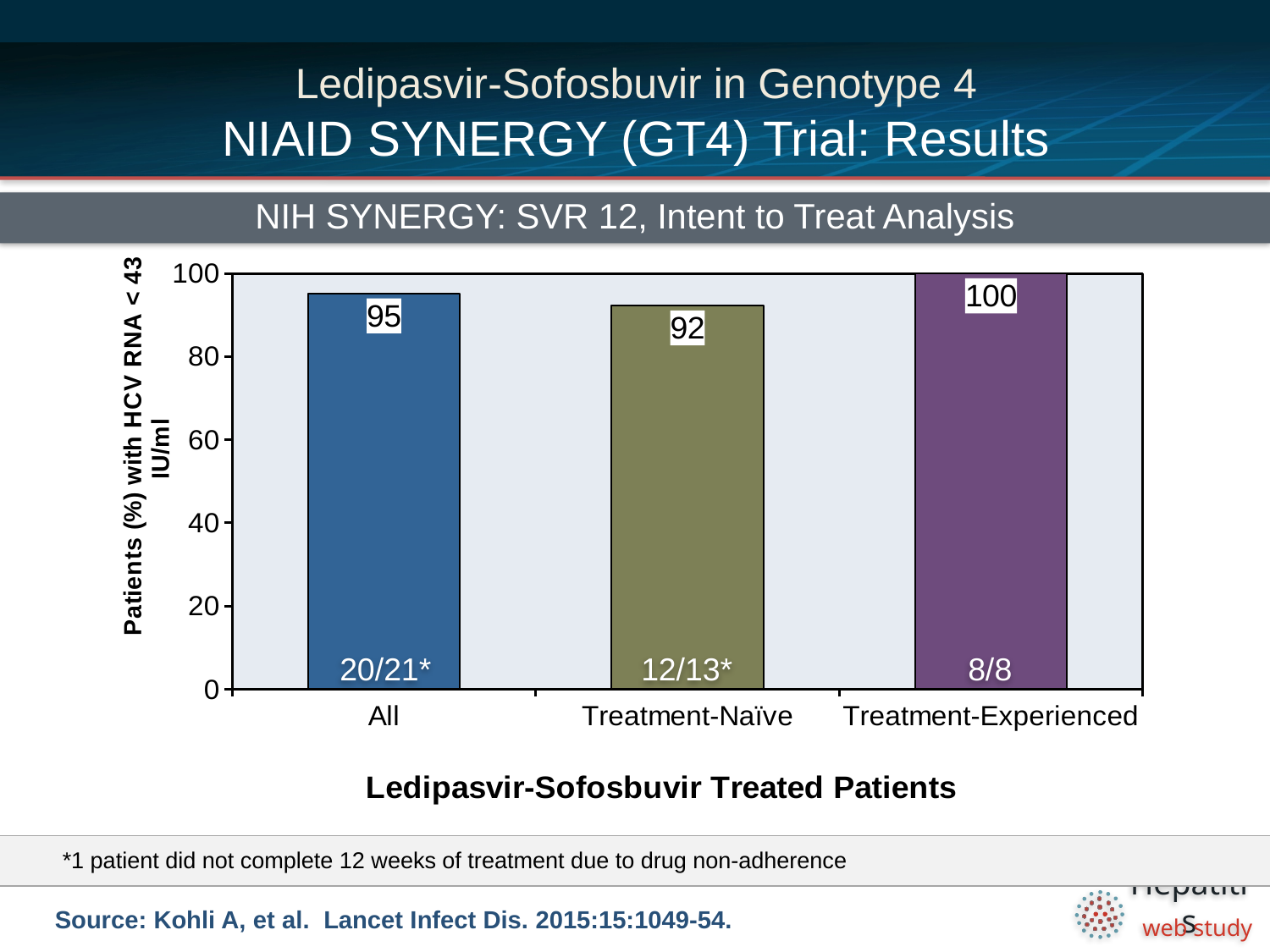
Which group has the highest SVR 12 value? Treatment-Experienced How many patient groups are shown on the x axis? 3 What is the SVR 12 value for the All group? 95 What kind of chart is shown on the slide? Bar chart What is the difference between the SVR 12 values for Treatment-Experienced and Treatment-Naïve? 8 What is the title of the chart? NIH SYNERGY: SVR 12, Intent to Treat Analysis What fraction of patients is printed on the bar for the Treatment-Experienced group? 8/8 Which group has the lowest SVR 12 value? Treatment-Naïve What is the SVR 12 value for the Treatment-Experienced group? 100 What is the SVR 12 value for the Treatment-Naïve group? 92 What is the difference between the SVR 12 values for All and Treatment-Naïve? 3 Which is larger, the value for All or the value for Treatment-Experienced? Treatment-Experienced